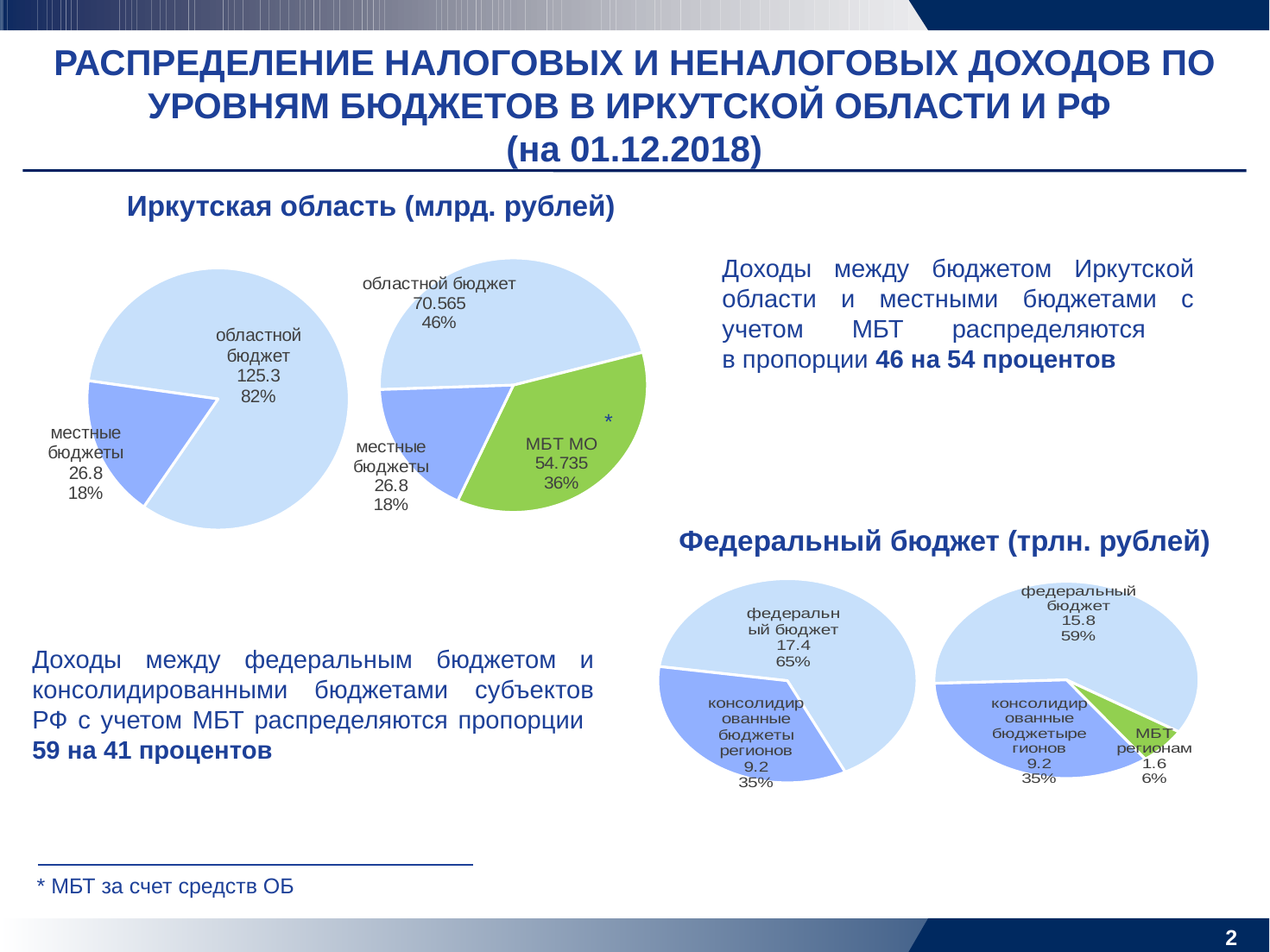
In the right pie chart under 'Федеральный бюджет (трлн. рублей)', what is the value for МБТ регионам? 1.6 What type of chart is used for the charts on this slide? Pie chart In the right pie chart under 'Иркутская область (млрд. рублей)', which slice is the largest? областной бюджет In the left pie chart under 'Федеральный бюджет (трлн. рублей)', what share of the pie is консолидированные бюджеты регионов? 35% In the left pie chart under 'Иркутская область (млрд. рублей)', what is the value for областной бюджет? 125.3 In the right pie chart under 'Иркутская область (млрд. рублей)', what is the value for МБТ МО? 54.735 In the right pie chart under 'Федеральный бюджет (трлн. рублей)', which slice is the smallest? МБТ регионам In the left pie chart under 'Иркутская область (млрд. рублей)', what share of the pie is местные бюджеты? 18% In the right pie chart under 'Иркутская область (млрд. рублей)', how many slices are there? 3 In the left pie chart under 'Федеральный бюджет (трлн. рублей)', what is the value for федеральный бюджет? 17.4 In the right pie chart under 'Иркутская область (млрд. рублей)', what is the difference between областной бюджет and МБТ МО? 15.83 In the right pie chart under 'Федеральный бюджет (трлн. рублей)', which is larger: федеральный бюджет or консолидированные бюджеты регионов? федеральный бюджет